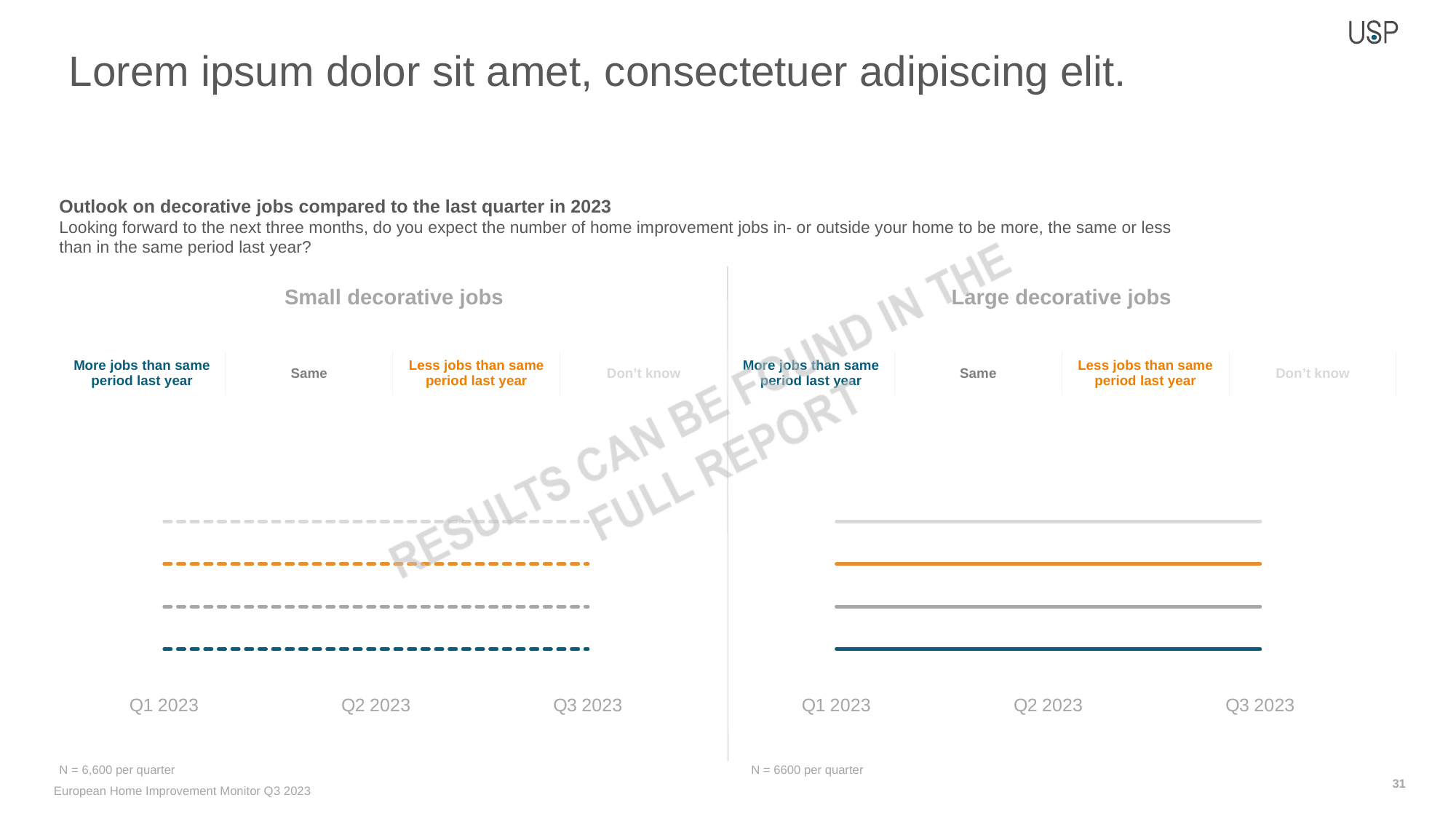
In the 'Small decorative jobs' chart, how many quarters are shown on the x axis? 3 How many series does the legend of the 'Small decorative jobs' chart list? 4 In the 'Large decorative jobs' chart, how many quarters are shown on the x axis? 3 How many series does the legend of the 'Large decorative jobs' chart list? 4 In the 'Large decorative jobs' chart, what colour is the 'Less jobs than same period last year' line? Orange In the 'Large decorative jobs' chart, does the 'More jobs than same period last year' line rise, fall or stay flat from Q1 2023 to Q3 2023? Stays flat What is the title of the chart on the left side of the slide? Small decorative jobs What kind of chart is the 'Large decorative jobs' chart? Line chart In the 'Small decorative jobs' chart, does the 'Less jobs than same period last year' line rise, fall or stay flat from Q1 2023 to Q3 2023? Stays flat What kind of chart is the 'Small decorative jobs' chart? Line chart